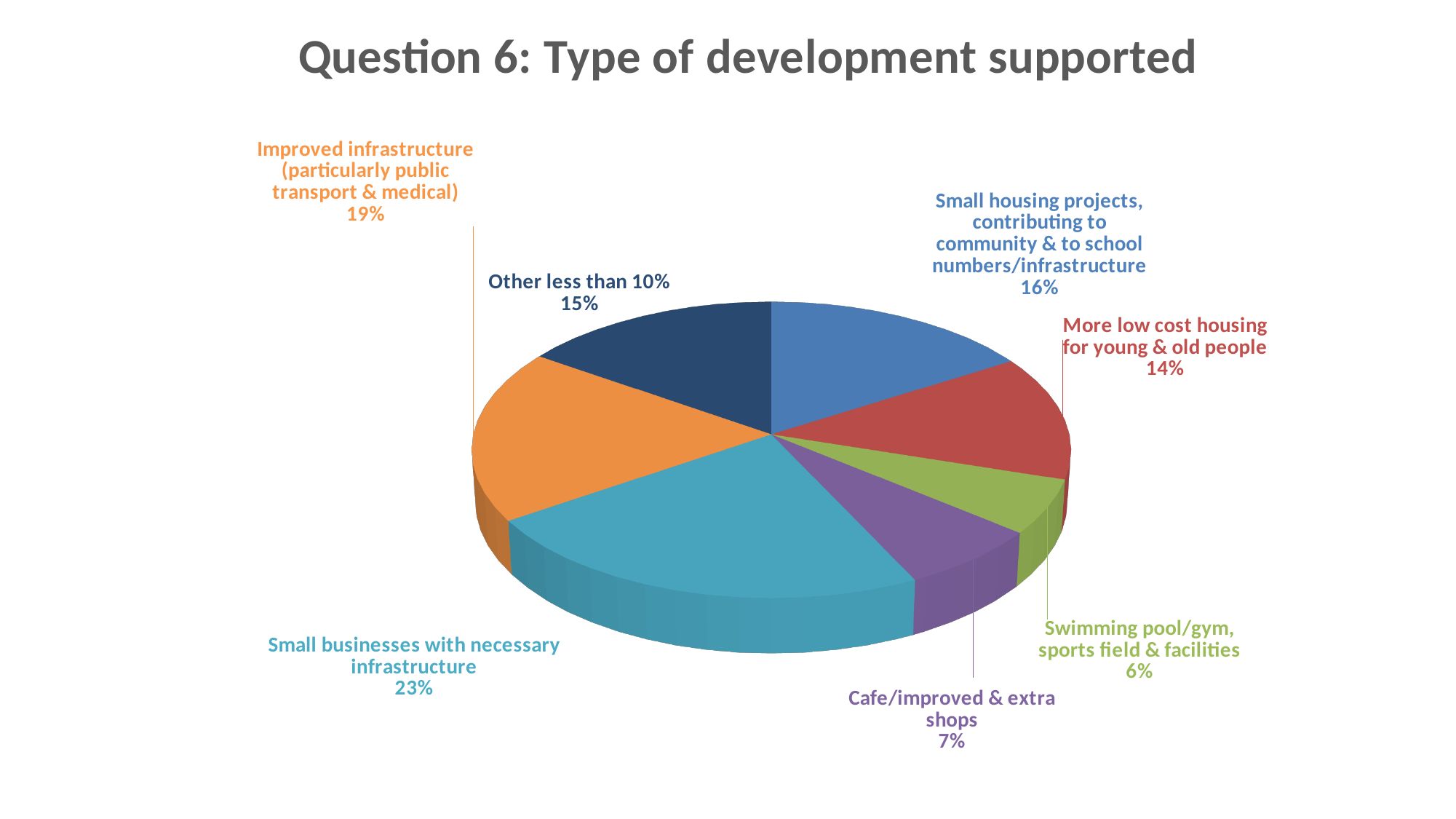
What colour is the slice for 'Swimming pool/gym, sports field & facilities'? Green What is the difference in percentage points between 'Small businesses with necessary infrastructure' and 'Other less than 10%'? 8 What is the title of the chart? Question 6: Type of development supported What kind of chart is shown on the slide? Pie chart What share of the pie is 'Small businesses with necessary infrastructure'? 23% What percentage is shown for 'More low cost housing for young & old people'? 14% How many categories are shown in the pie chart? 7 Which category has the largest slice of the pie? Small businesses with necessary infrastructure Which is larger: 'Small housing projects, contributing to community & to school numbers/infrastructure' or 'More low cost housing for young & old people'? Small housing projects, contributing to community & to school numbers/infrastructure What percentage is shown for 'Cafe/improved & extra shops'? 7% What percentage is shown for 'Improved infrastructure (particularly public transport & medical)'? 19% Which category has the smallest slice of the pie? Swimming pool/gym, sports field & facilities